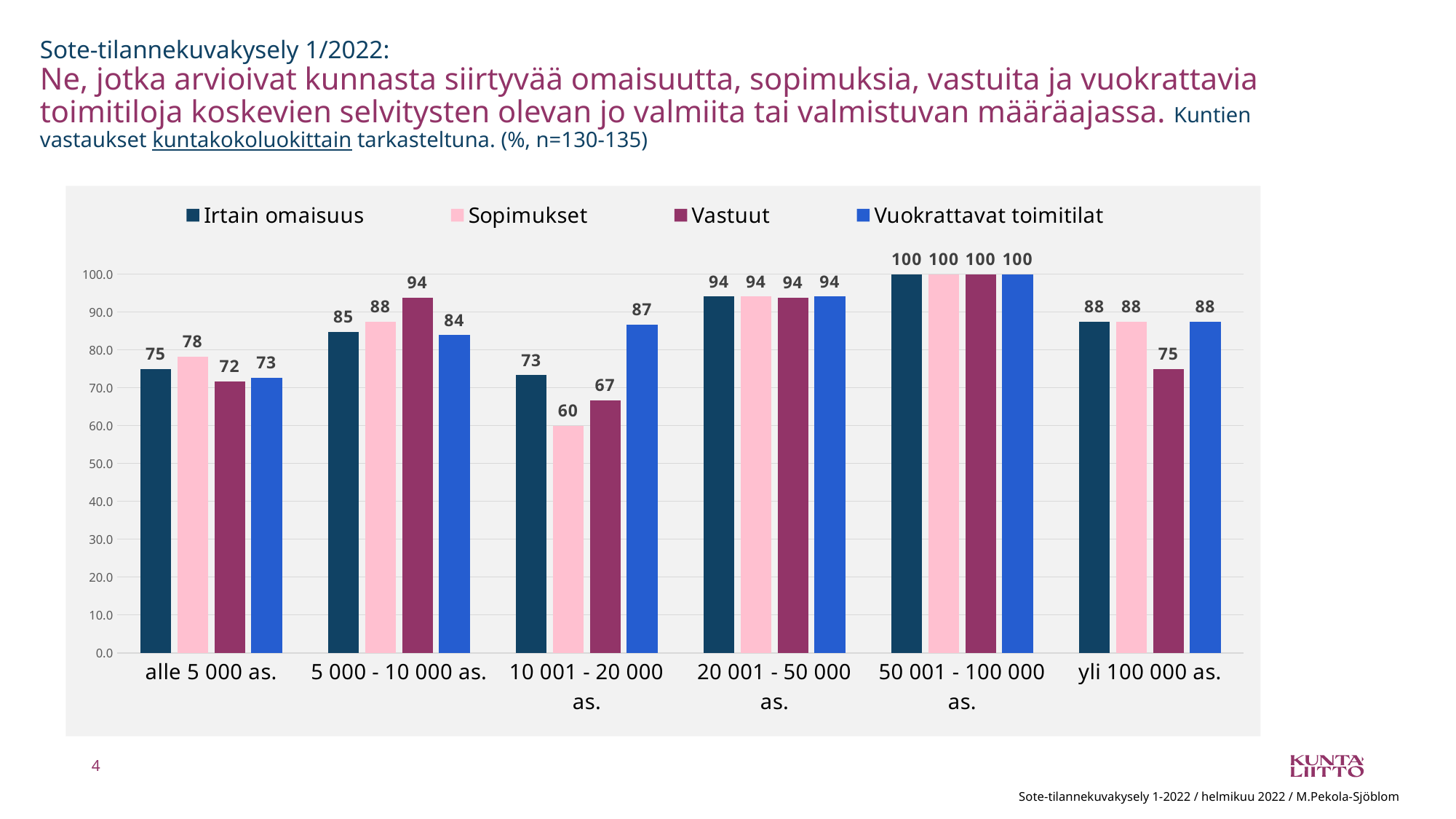
What is the value for Sopimukset in the 10 001 - 20 000 as. category? 60 Which category has the lowest value for Sopimukset? 10 001 - 20 000 as. Which category has the highest value for Irtain omaisuus? 50 001 - 100 000 as. What kind of chart is shown on the slide? bar chart Is the value for Vastuut in the alle 5 000 as. category greater or less than 80? less What is the value for Vuokrattavat toimitilat in the alle 5 000 as. category? 73 What is the value for Vastuut in the 5 000 - 10 000 as. category? 94 How many categories are shown on the x axis? 6 What is the difference between Vuokrattavat toimitilat and Sopimukset in the 10 001 - 20 000 as. category? 27 How many series does the legend list? 4 Which series is shown in pink in the legend? Sopimukset In the yli 100 000 as. category, which is larger: Irtain omaisuus or Vastuut? Irtain omaisuus